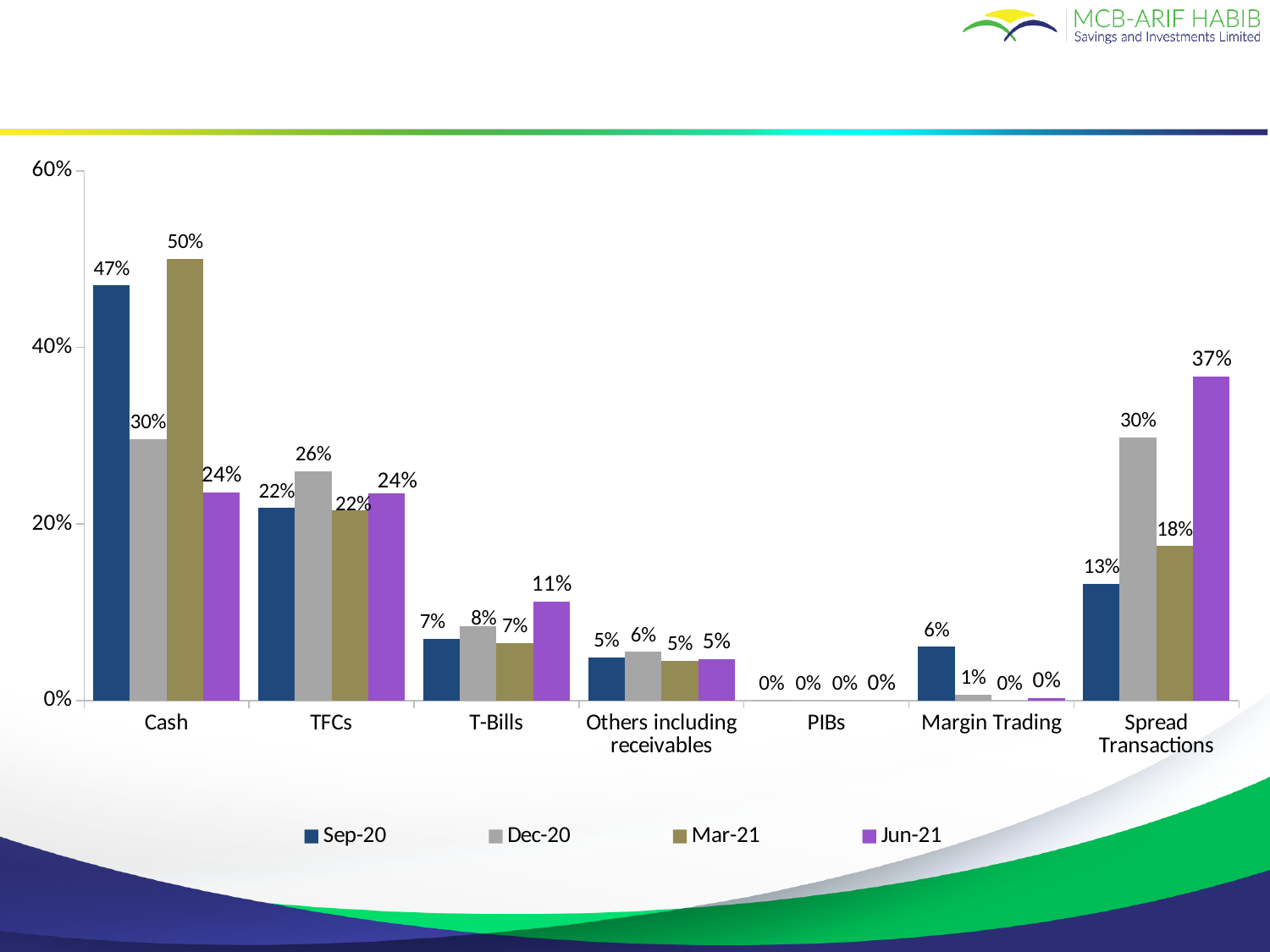
Which is larger: Spread Transactions in Dec-20 or Spread Transactions in Mar-21? Spread Transactions in Dec-20 What is the value for Spread Transactions in Jun-21? 37% How many categories are shown on the x axis? 7 What kind of chart is shown on the slide? Bar chart What is the value for T-Bills in Dec-20? 8% What is the value for Cash in Mar-21? 50% How many series does the legend list? 4 Which series is shown in purple in the legend? Jun-21 What is the difference between the Cash values for Sep-20 and Jun-21? 23% Is the value for Cash in Mar-21 greater or less than 40%? greater Which category has the highest value in the Sep-20 series? Cash